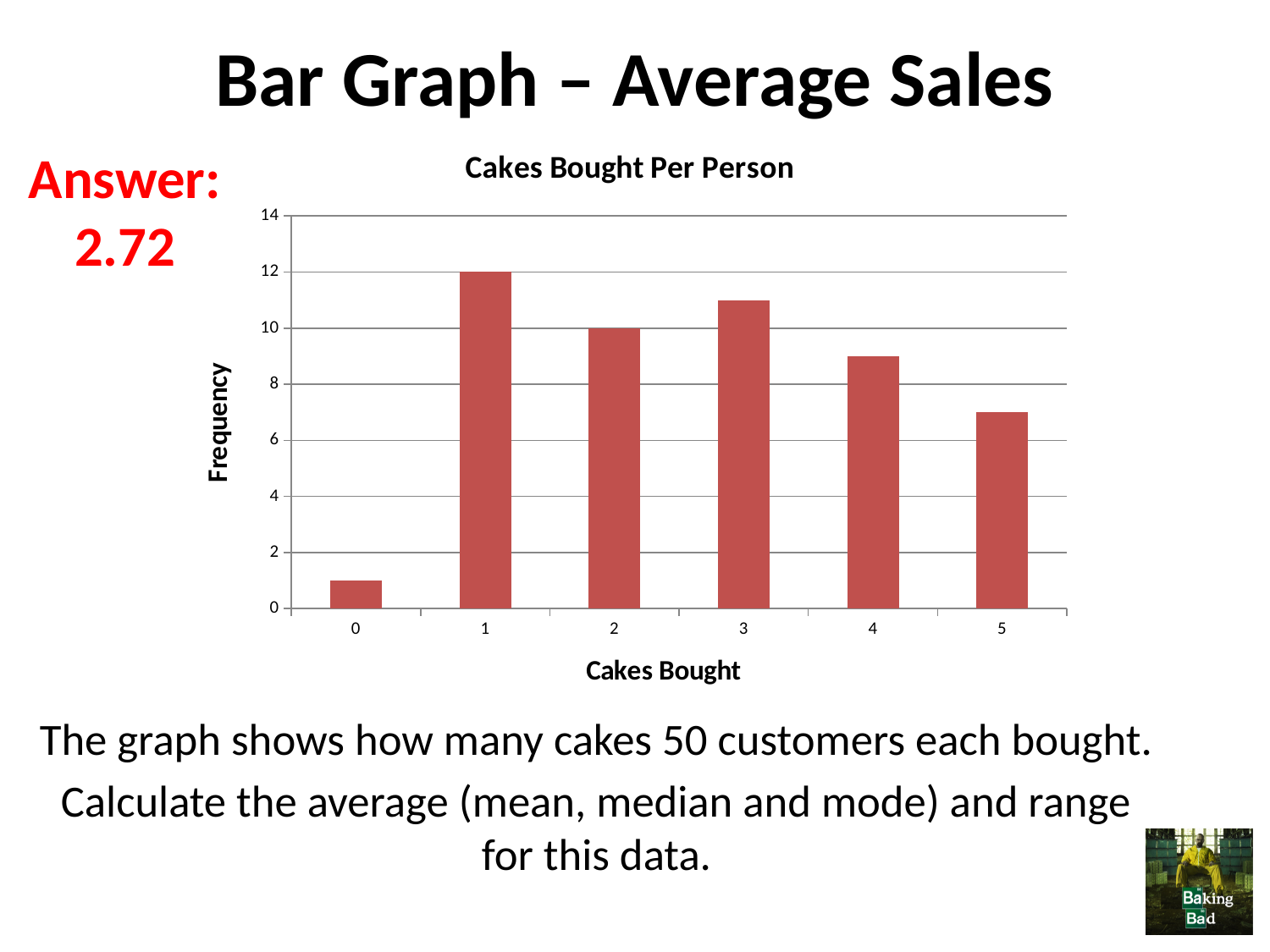
Which has the larger frequency, 1 cake bought or 5 cakes bought? 1 cake bought Which number of cakes bought has the lowest frequency? 0 What is the frequency for 1 cake bought? 12 Which number of cakes bought has the highest frequency? 1 What is the frequency for 2 cakes bought? 10 How many categories of cakes bought are shown on the x axis? 6 What is the title of the chart? Cakes Bought Per Person Is the frequency for 3 cakes bought greater or less than 10? greater What kind of chart is shown on the slide? Bar chart What is the difference in frequency between 1 cake bought and 2 cakes bought? 2 Is the frequency for 5 cakes bought greater or less than 8? less Is the frequency for 0 cakes bought greater or less than 2? less